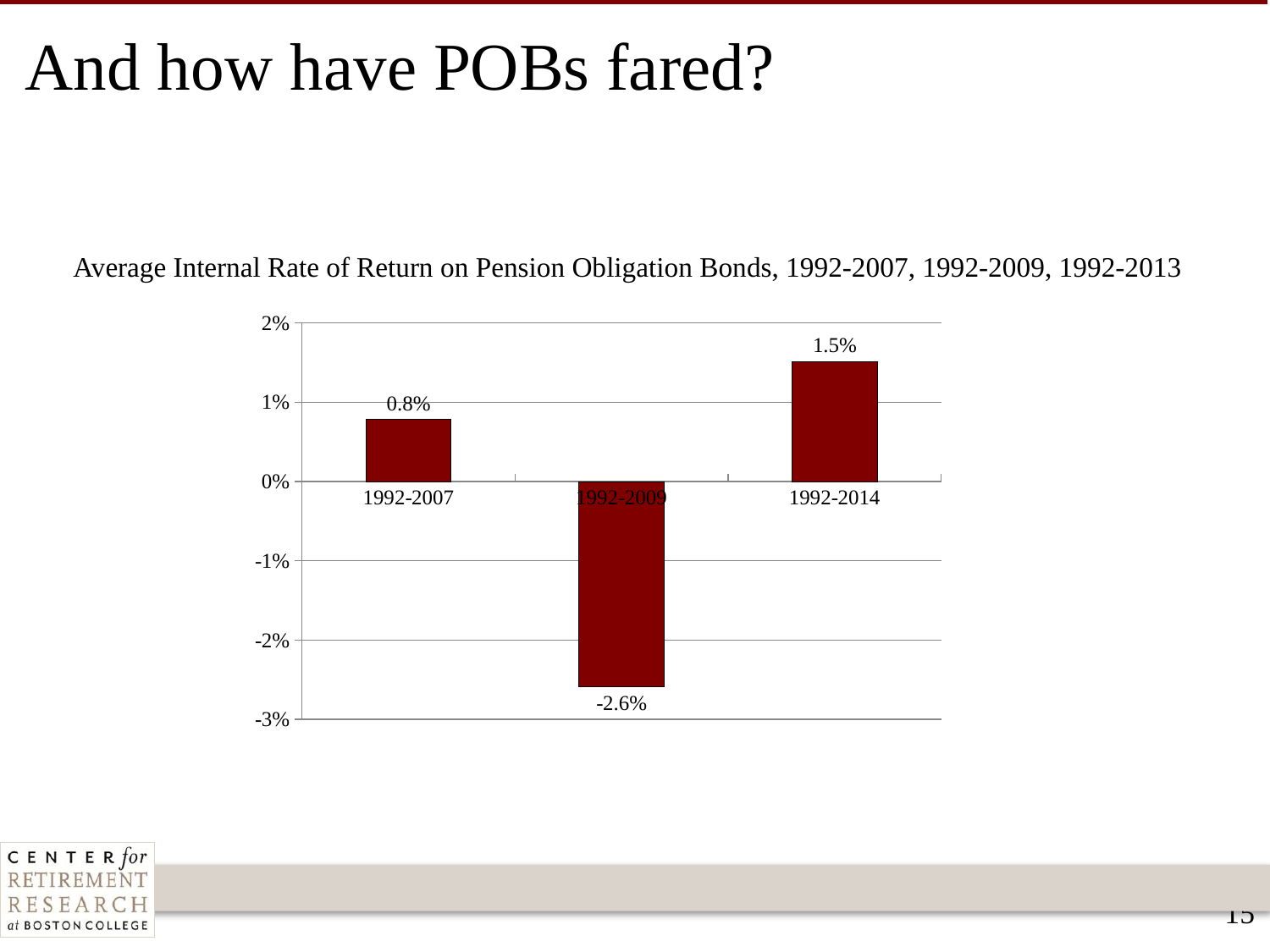
Is the value for 1992-2009 greater or less than -2%? less Which is larger, the rate of return for 1992-2007 or for 1992-2014? 1992-2014 What is the average internal rate of return for 1992-2014? 1.5% What is the average internal rate of return for 1992-2007? 0.8% What is the difference between the rate of return for 1992-2014 and 1992-2007? 0.7% Which period has the lowest average internal rate of return? 1992-2009 How many periods are shown in the chart? 3 What kind of chart is shown on the slide? Bar chart How many of the periods show a negative rate of return? 1 Which period has the highest average internal rate of return? 1992-2014 What is the title of the chart? Average Internal Rate of Return on Pension Obligation Bonds, 1992-2007, 1992-2009, 1992-2013 What is the average internal rate of return for 1992-2009? -2.6%